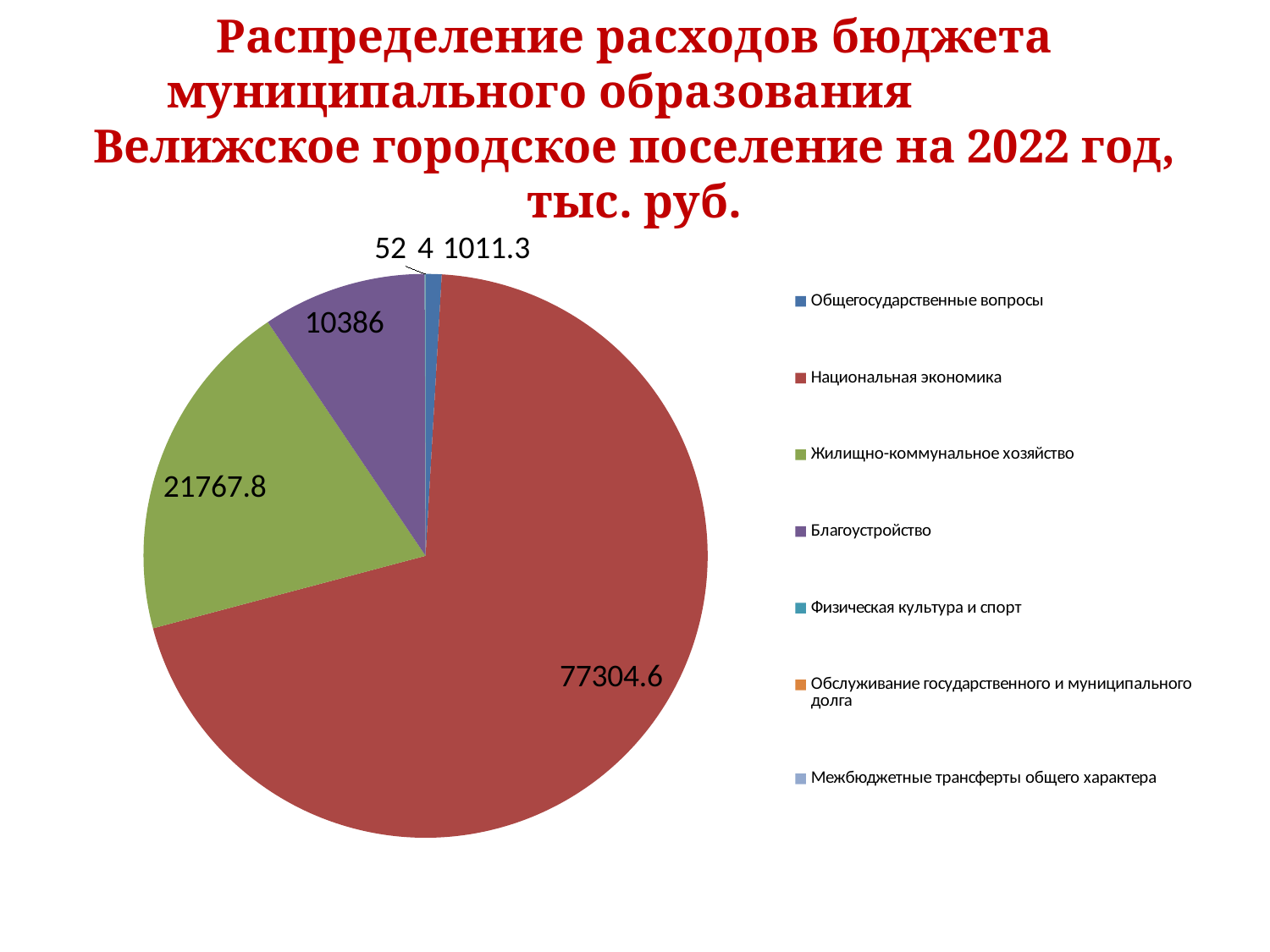
What is the value for Национальная экономика? 77304.6 Which is larger, the value for Благоустройство or the value for Жилищно-коммунальное хозяйство? Жилищно-коммунальное хозяйство How many categories does the legend list? 7 What kind of chart is shown on the slide? pie chart For which year does the chart show the budget expenditure distribution? 2022 What is the value for Общегосударственные вопросы? 1011.3 What is the value for Благоустройство? 10386 What is the difference between the values for Жилищно-коммунальное хозяйство and Благоустройство? 11381.8 What is the value for Жилищно-коммунальное хозяйство? 21767.8 Which category has the largest slice of the pie? Национальная экономика What is the difference between the values for Национальная экономика and Жилищно-коммунальное хозяйство? 55536.8 What colour is the slice for Национальная экономика? red